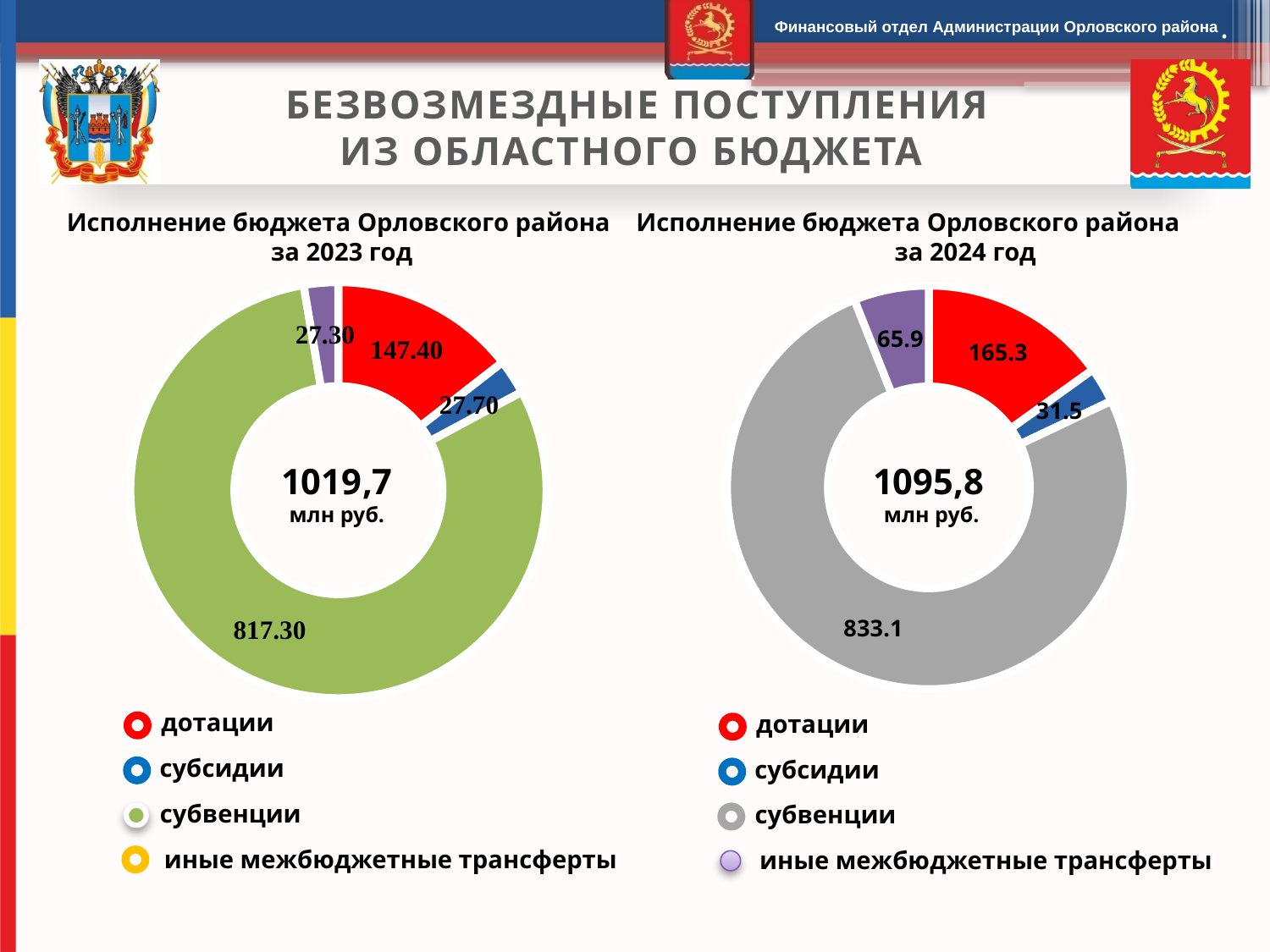
What is the difference between the дотации value in the 2024 chart (165.3) and the дотации value in the 2023 chart (147.40)? 17.9 In the chart 'Исполнение бюджета Орловского района за 2024 год', what is the value for субвенции? 833.1 What is the difference between the субвенции value in the 2024 chart and the субвенции value in the 2023 chart? 15.8 In the chart 'Исполнение бюджета Орловского района за 2024 год', which category has the smallest value? субсидии What type of chart is used for 'Исполнение бюджета Орловского района за 2023 год'? pie (donut) chart What total is shown in the centre of the chart 'Исполнение бюджета Орловского района за 2023 год'? 1019,7 млн руб. Which is larger: the субсидии value in the 2023 chart or the субсидии value in the 2024 chart? 2024 chart What total is shown in the centre of the chart 'Исполнение бюджета Орловского района за 2024 год'? 1095,8 млн руб. In the chart 'Исполнение бюджета Орловского района за 2023 год', which category has the largest value? субвенции How many slices does the chart 'Исполнение бюджета Орловского района за 2024 год' have? 4 In the chart 'Исполнение бюджета Орловского района за 2023 год', what is the value for дотации? 147.40 In the chart 'Исполнение бюджета Орловского района за 2024 год', what is the value for субсидии? 31.5